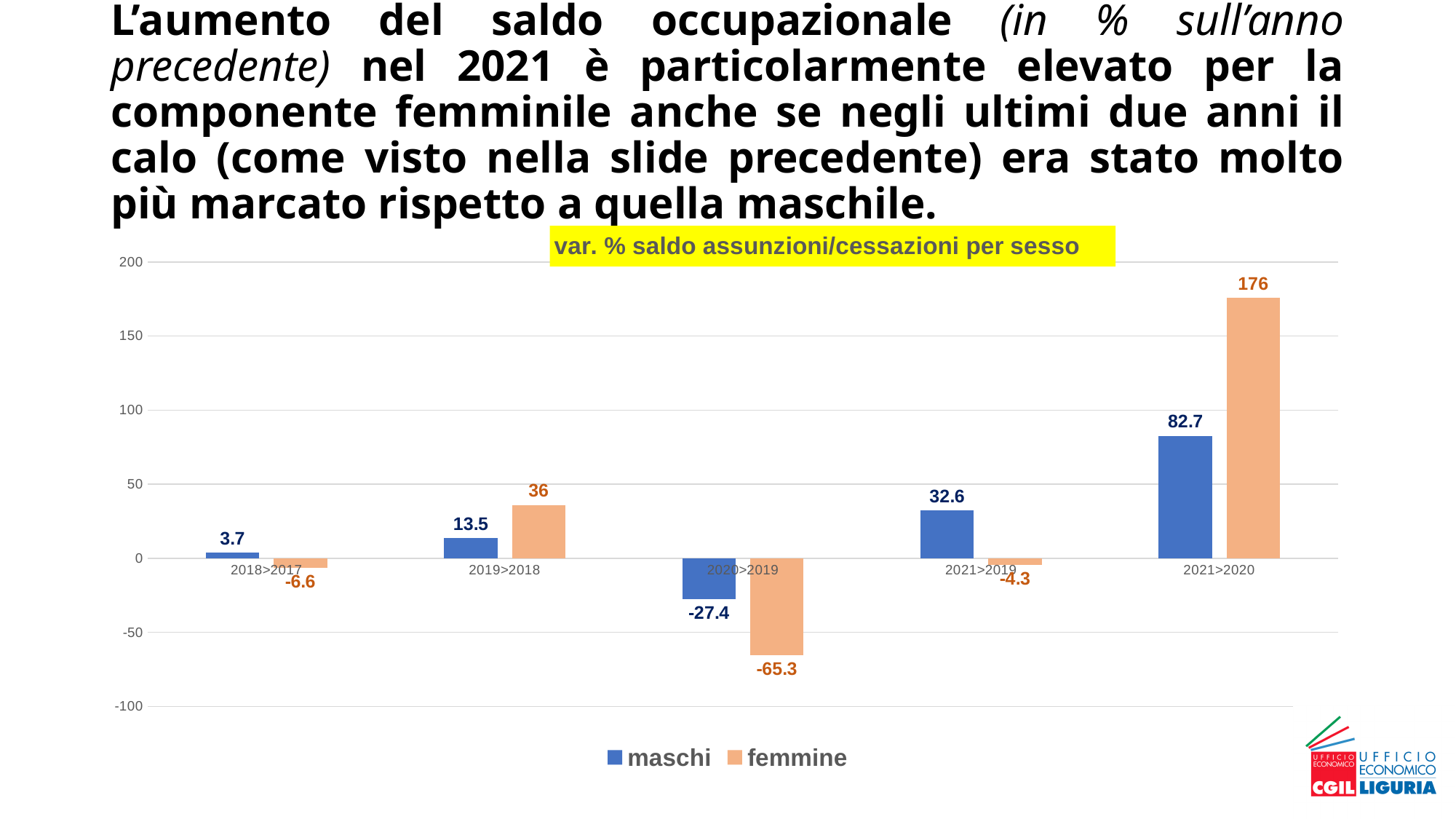
How many series does the legend list? 2 In 2019>2018, which series has the larger value, maschi or femmine? femmine What is the difference between the femmine and maschi values in 2021>2020? 93.3 Which category has the lowest value for maschi? 2020>2019 What kind of chart is shown on the slide? bar chart Which category has the highest value for femmine? 2021>2020 What is the value for femmine in 2020>2019? -65.3 How many categories are shown on the x axis? 5 What is the value for femmine in 2018>2017? -6.6 What is the value for maschi in 2021>2019? 32.6 What is the title of the chart? var. % saldo assunzioni/cessazioni per sesso What is the value for maschi in 2021>2020? 82.7